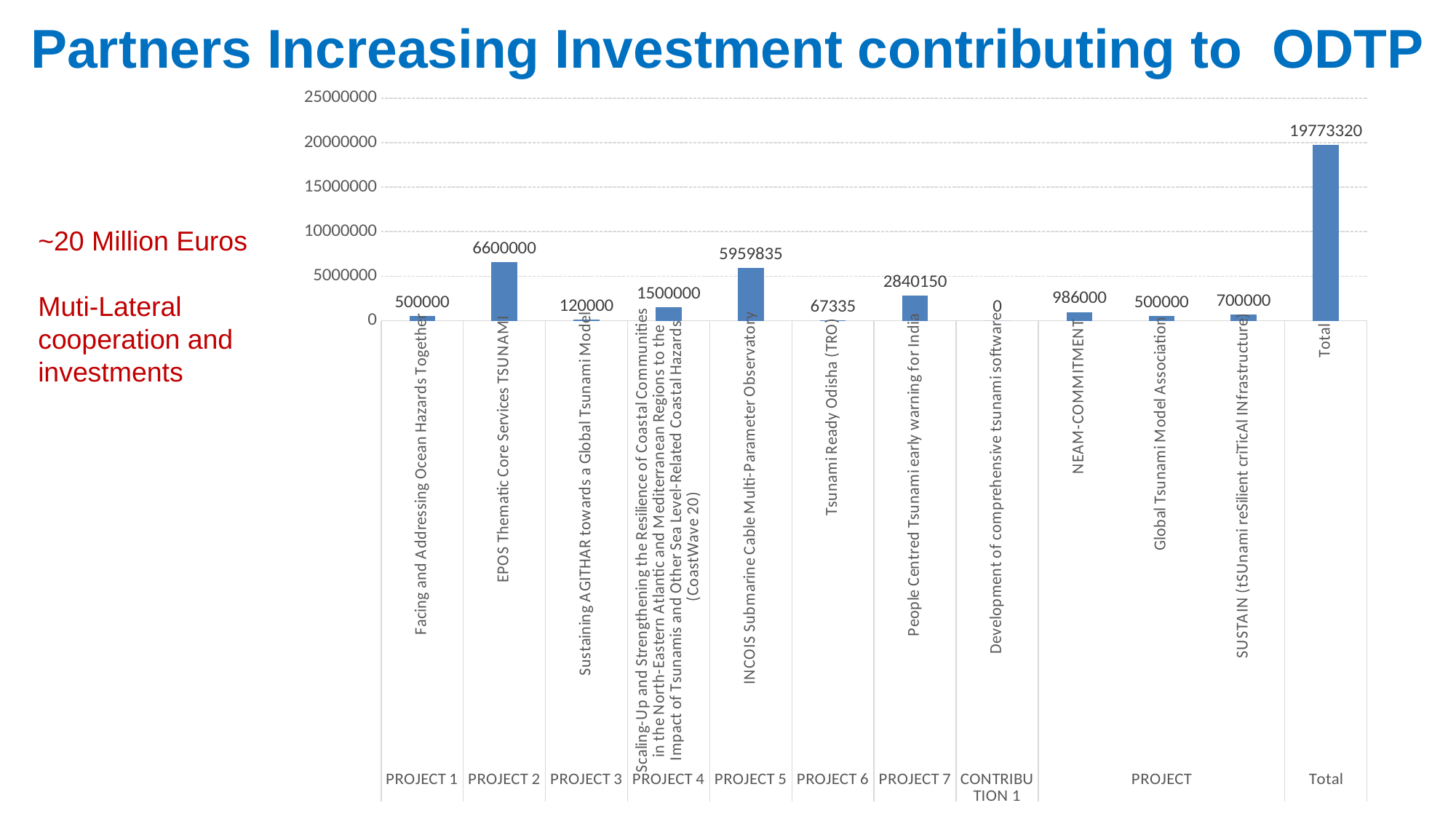
What is the value for Tsunami Ready Odisha (TRO)? 67335 What is the value shown for the Total bar? 19773320 What is the value for INCOIS Submarine Cable Multi-Parameter Observatory? 5959835 Excluding the Total bar, which category has the highest value? EPOS Thematic Core Services TSUNAMI What kind of chart is shown on the slide? Bar chart What is the value for NEAM-COMMITMENT? 986000 What is the value for EPOS Thematic Core Services TSUNAMI? 6600000 What is the difference between the values for EPOS Thematic Core Services TSUNAMI and INCOIS Submarine Cable Multi-Parameter Observatory? 640165 How many bars are plotted in the chart, including the Total bar? 12 Is the value for the Total bar greater or less than 15000000? greater Which is larger, the value for People Centred Tsunami early warning for India or the value for the CoastWave 20 project? People Centred Tsunami early warning for India Which category has the lowest value? Development of comprehensive tsunami software